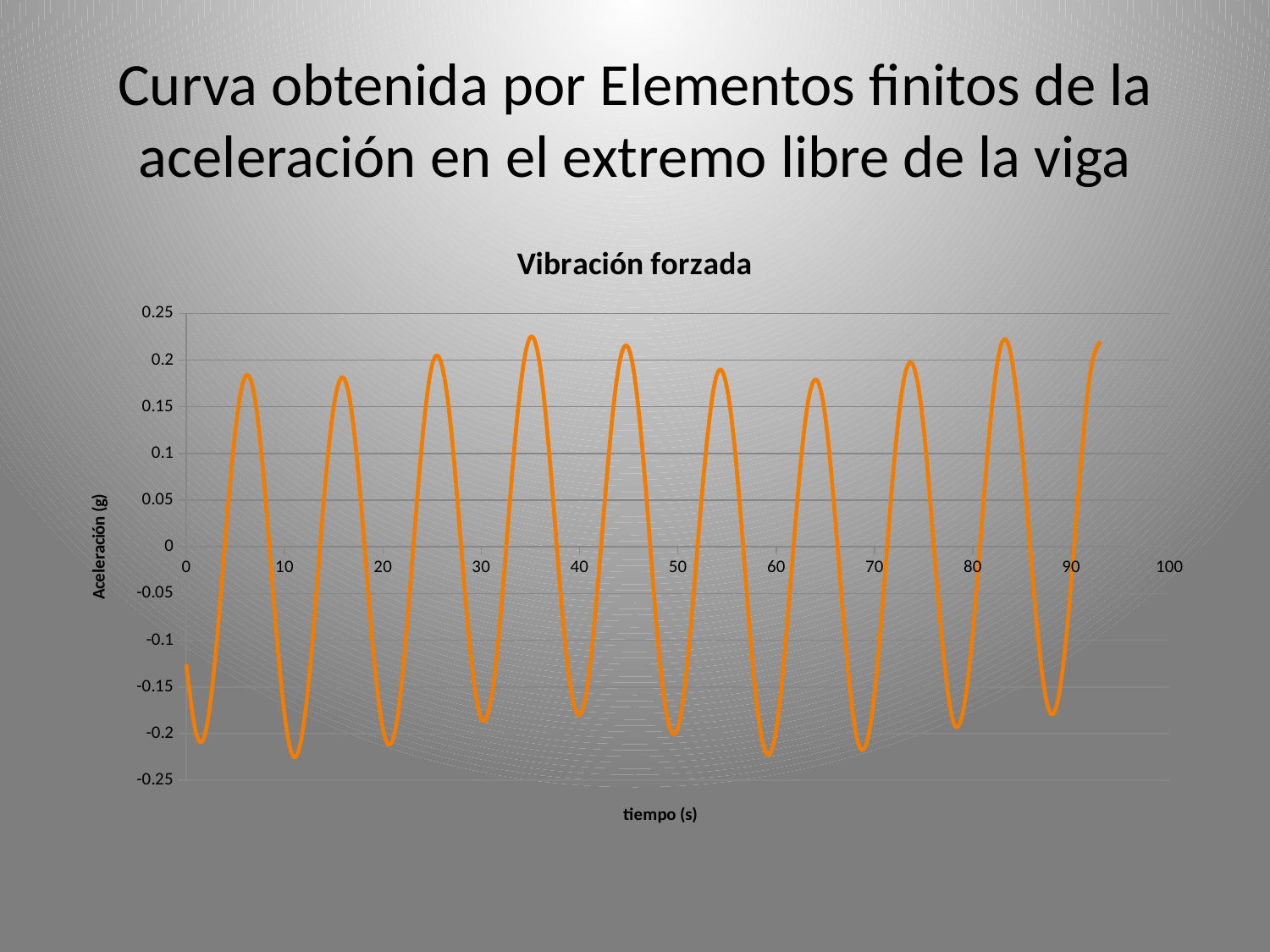
What is the title of the chart? Vibración forzada Is the highest peak of the curve greater or less than 0.2? greater Is the highest peak of the curve greater or less than 0.25? less What kind of chart is shown on the slide? line chart Is the trough of the curve near tiempo 30 s greater or less than -0.15? less What colour is the plotted line in the chart? orange